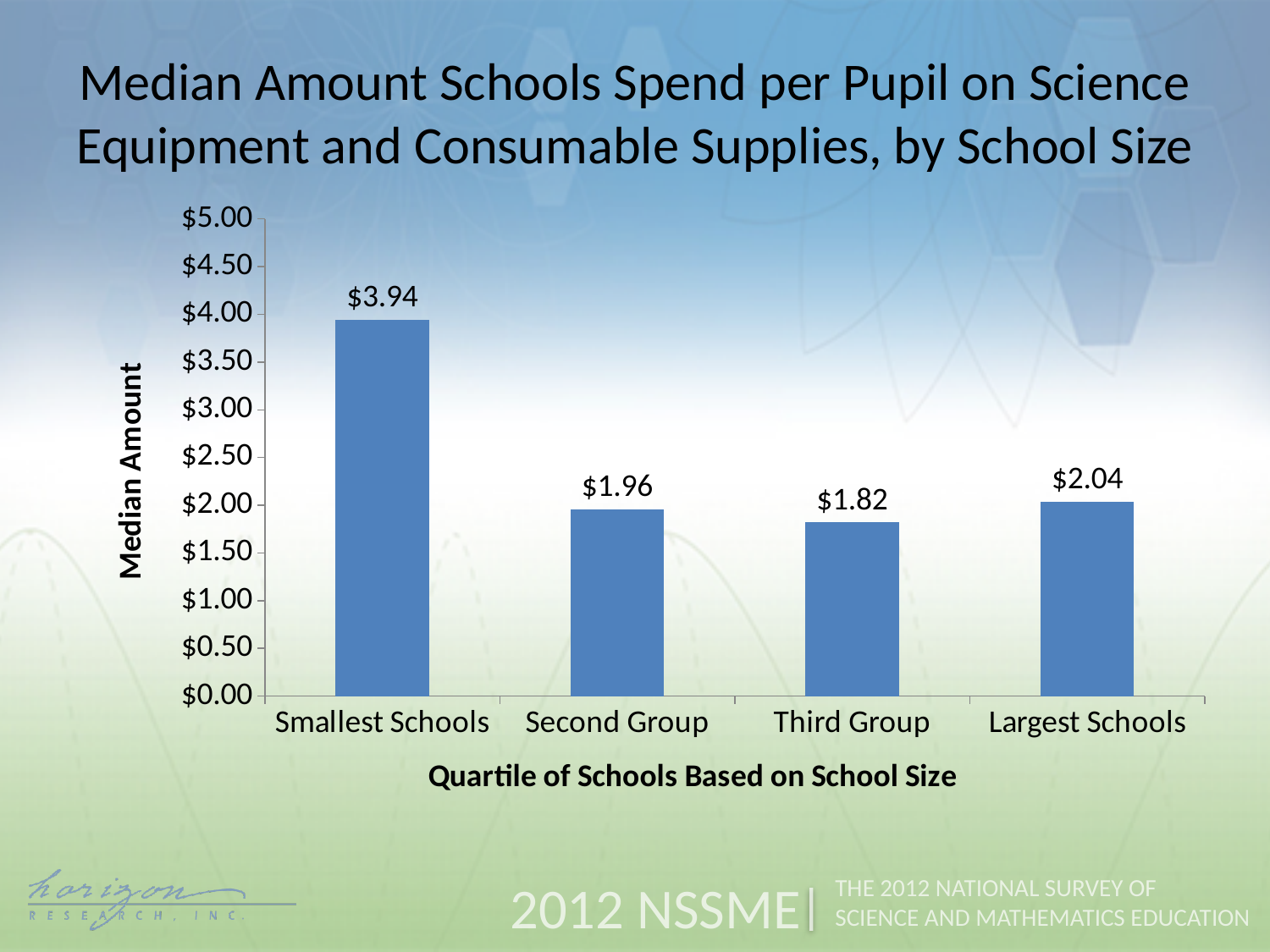
How many quartile categories are shown on the x axis? 4 Which has a larger median amount spent per pupil, the Second Group or the Largest Schools? Largest Schools Is the median amount for the Third Group greater or less than $2.00? less What is the median amount spent per pupil for the Third Group? $1.82 What is the median amount spent per pupil for Smallest Schools? $3.94 Which quartile of schools has the lowest median amount spent per pupil? Third Group What is the median amount spent per pupil for Largest Schools? $2.04 What is the label of the x axis? Quartile of Schools Based on School Size What kind of chart is shown on the slide? Bar chart Which quartile of schools has the highest median amount spent per pupil? Smallest Schools What is the difference between the median amount for Smallest Schools and Largest Schools? $1.90 What is the median amount spent per pupil for the Second Group? $1.96